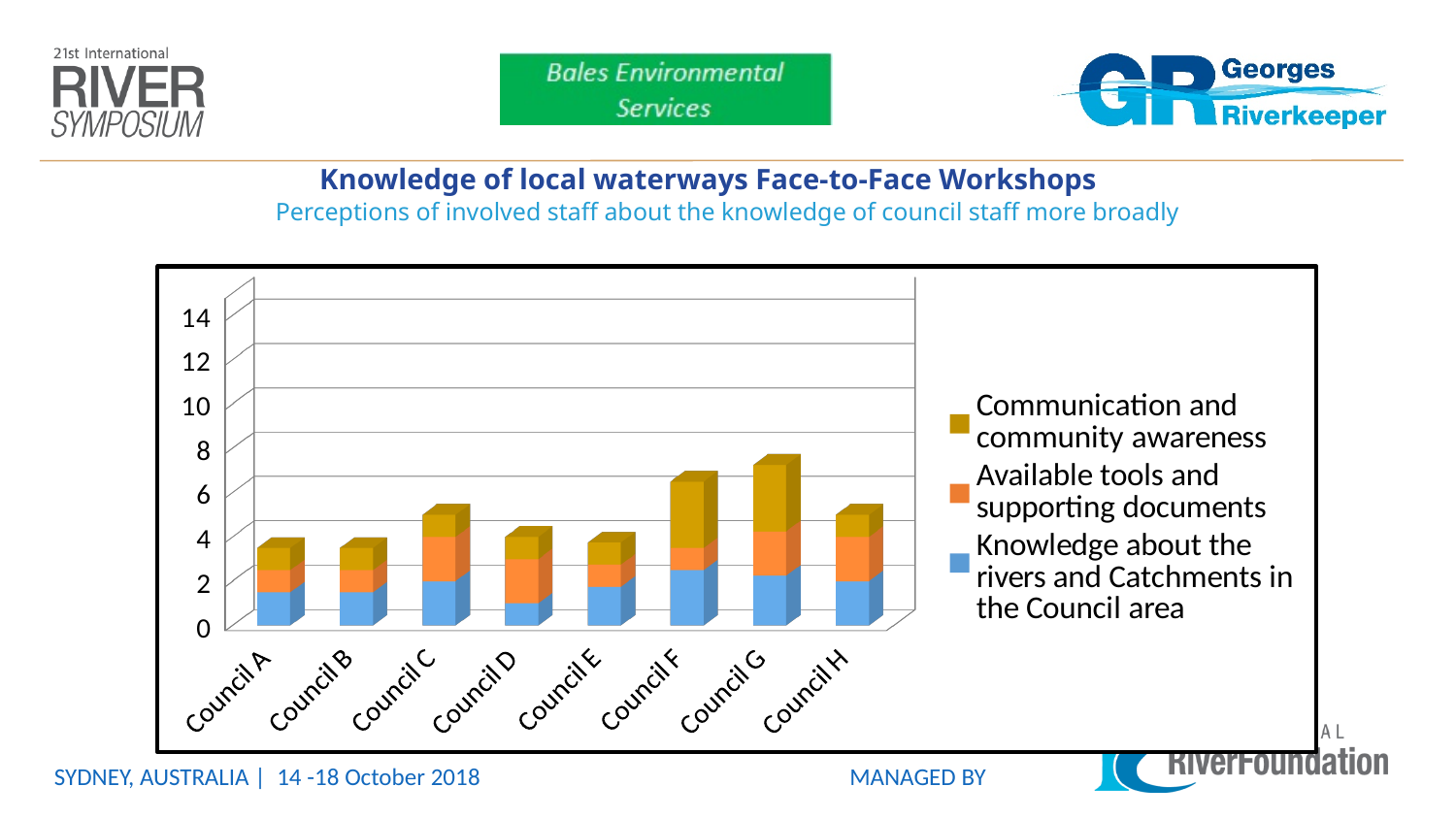
Is the total stacked value for Council A greater or less than 4? less Which council has the tallest stacked bar in the chart? Council G Is the total stacked value for Council C greater or less than 6? less Which has the taller stacked bar, Council G or Council A? Council G Which has the taller stacked bar, Council F or Council C? Council F What is the title of the chart on the slide? Knowledge of local waterways Face-to-Face Workshops Which legend entry is shown in gold/yellow in the chart? Communication and community awareness Is the total stacked value for Council D greater or less than 6? less How many councils are shown on the x axis of the chart? 8 What kind of chart is shown on the slide? Stacked bar chart How many series does the chart's legend list? 3